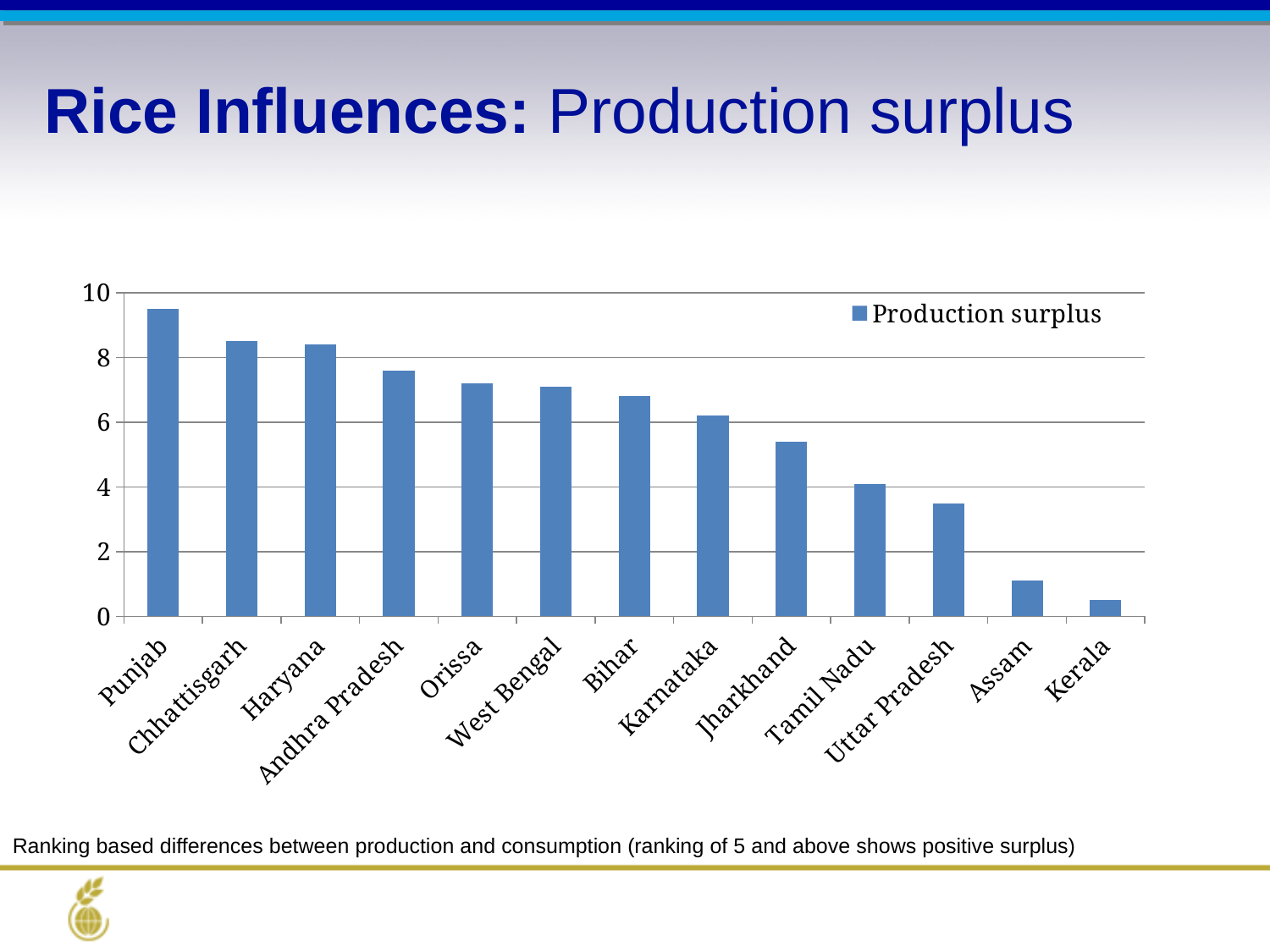
Is the value for Assam greater or less than 2? less Do the values rise or fall moving from left to right along the x axis? fall Which has a larger production surplus, Haryana or Tamil Nadu? Haryana Which state has the highest production surplus? Punjab How many states are shown on the x axis of the chart? 13 Is the value for Jharkhand greater or less than 6? less What is the name of the series shown in the legend? Production surplus What kind of chart is shown on the slide? bar chart Is the value for Punjab greater or less than 8? greater Which state has the lowest production surplus? Kerala How many series does the legend list? 1